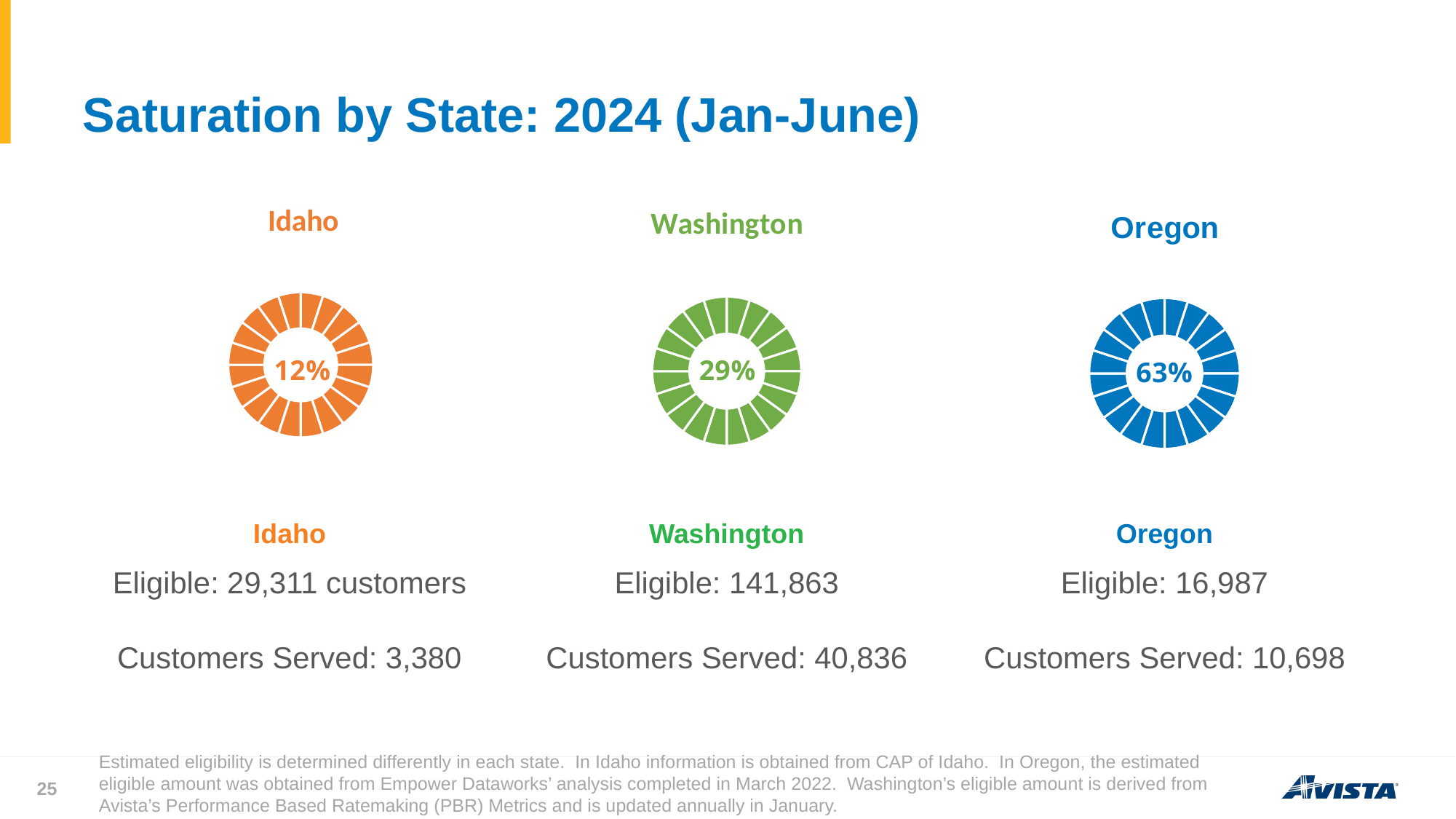
What is the title of the slide containing the charts? Saturation by State: 2024 (Jan-June) What saturation percentage is shown in the centre of the Oregon chart? 63% How many state charts are shown on the slide? 3 What saturation percentage is shown in the centre of the Washington chart? 29% Is the saturation percentage shown for Washington higher or lower than that shown for Oregon? lower Which state's chart shows the highest saturation percentage? Oregon Which state's chart shows the lowest saturation percentage? Idaho What kind of chart is used to show each state's saturation percentage? Doughnut (ring) chart What is the difference in percentage points between the Oregon chart's value and the Idaho chart's value? 51 percentage points What colour is the Washington chart? Green What is the difference in percentage points between the Washington chart's value and the Idaho chart's value? 17 percentage points What saturation percentage is shown in the centre of the Idaho chart? 12%